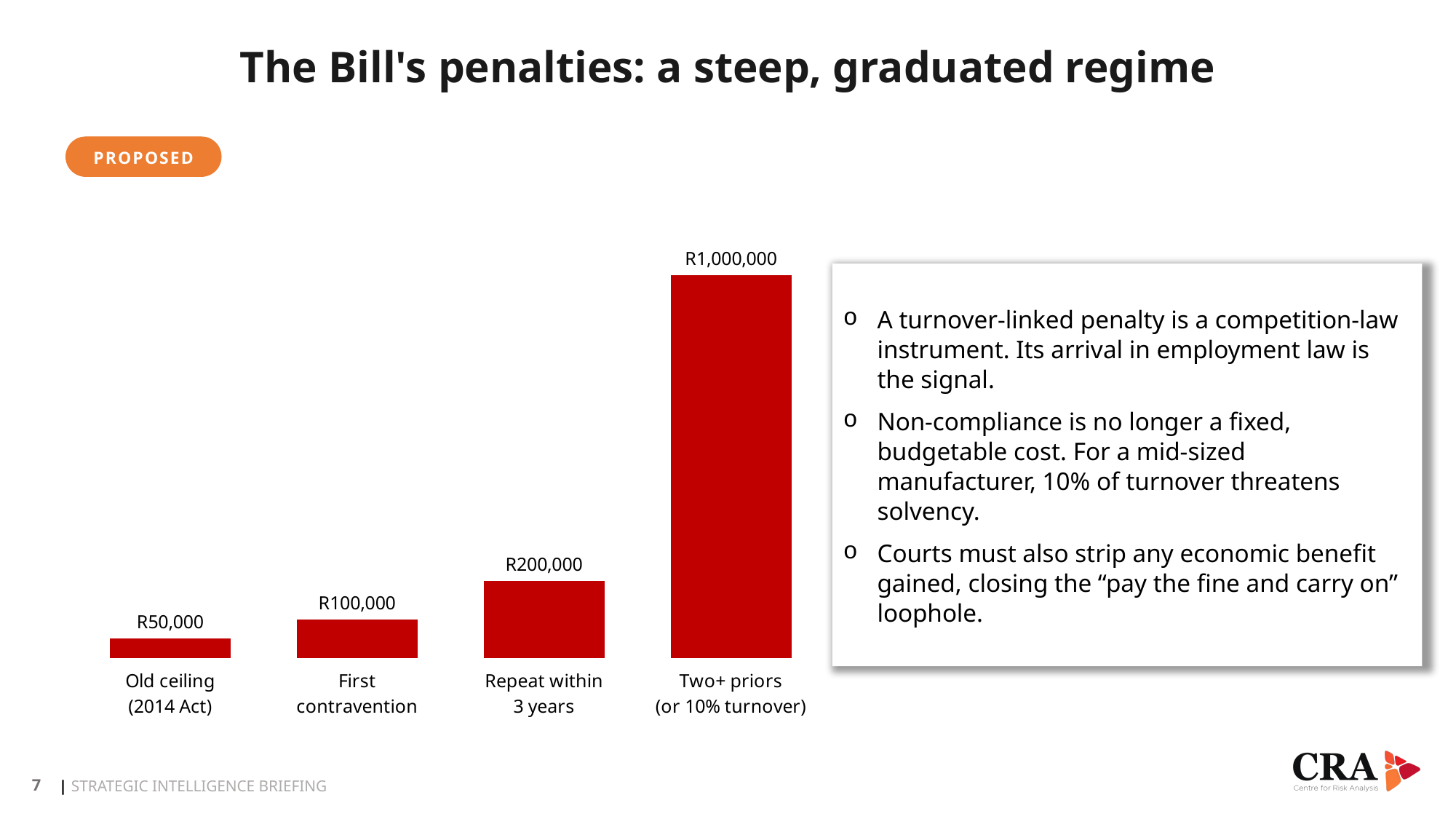
What is the value for Two+ priors (or 10% turnover)? R1,000,000 What is the difference between the values for First contravention and Old ceiling (2014 Act)? R50,000 Do the values rise or fall from left to right across the categories? Rise What is the value for Repeat within 3 years? R200,000 How many categories are shown in the chart? 4 Which is larger, the value for Repeat within 3 years or the value for First contravention? Repeat within 3 years What is the difference between the values for Two+ priors (or 10% turnover) and Repeat within 3 years? R800,000 What kind of chart is shown on the slide? Bar chart Which category has the highest value? Two+ priors (or 10% turnover) What is the value for Old ceiling (2014 Act)? R50,000 Which category has the lowest value? Old ceiling (2014 Act) What is the value for First contravention? R100,000